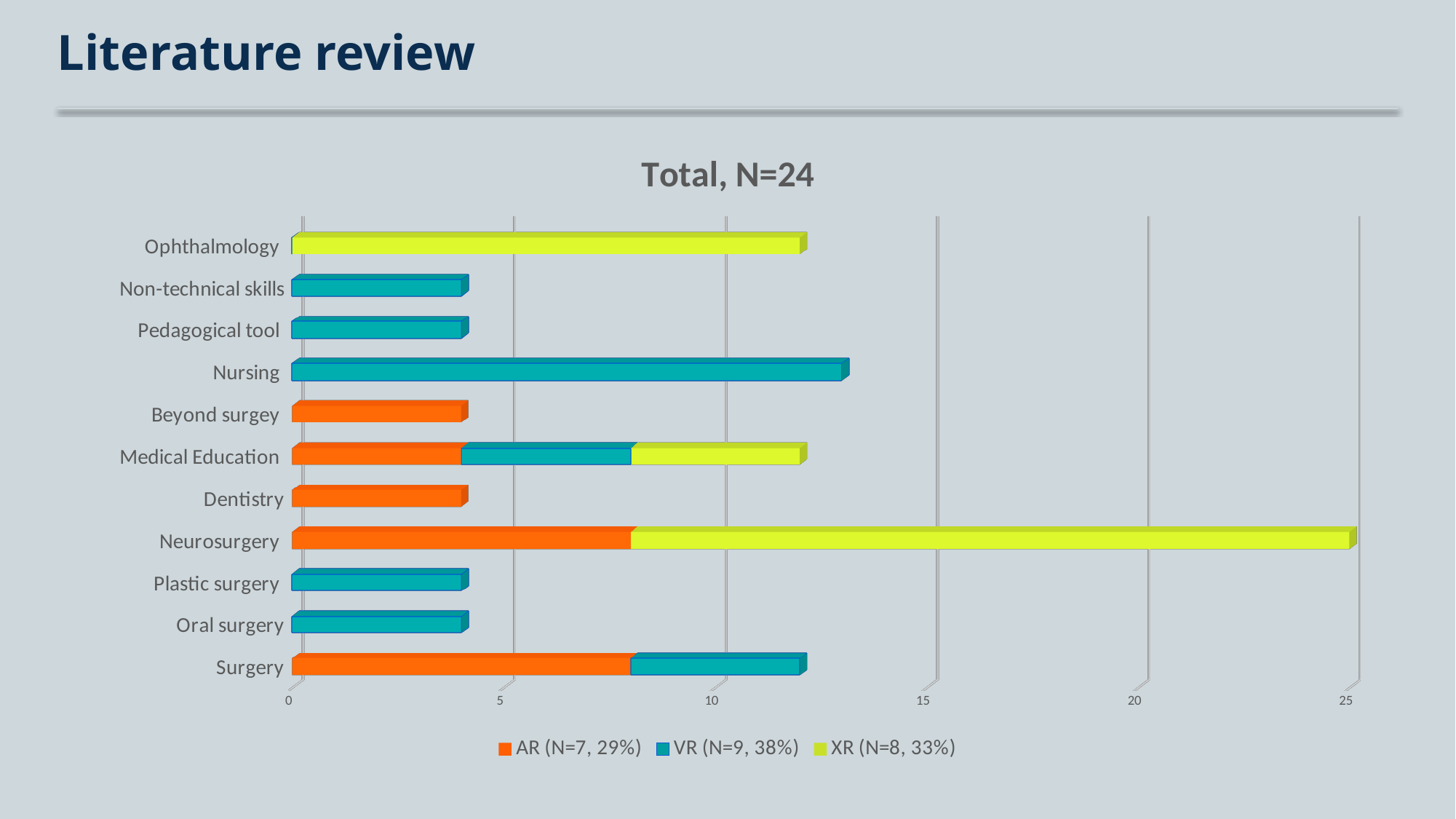
Is the value for Beyond surgey greater or less than 5? less Which has the longer bar, Nursing or Dentistry? Nursing How many series does the legend list? 3 How many categories are shown on the vertical axis of the chart? 11 Which category has the longest bar in the chart? Neurosurgery Is the total bar length for Neurosurgery greater or less than 20? greater What legend entry is shown for the yellow-green series? XR (N=8, 33%) What kind of chart is shown on the slide? bar chart Is the value for Ophthalmology greater or less than 10? greater What is the title of the chart? Total, N=24 Which has the longer total bar, Surgery or Neurosurgery? Neurosurgery